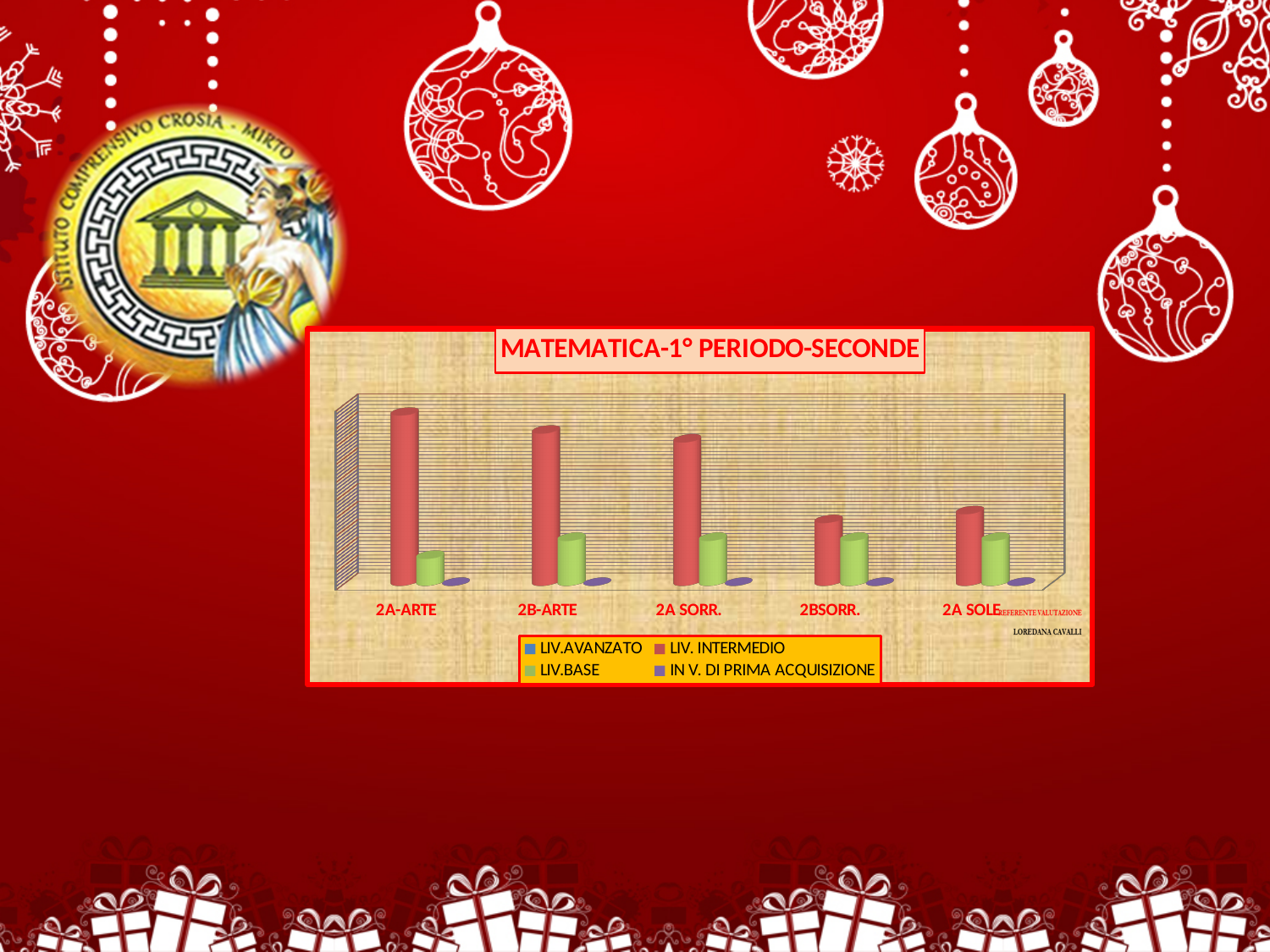
Which class has the lowest LIV. INTERMEDIO bar? 2BSORR. How many classes (categories) are shown on the x axis of the chart? 5 Which colour represents LIV.BASE in the legend? green How many series does the chart legend list? 4 Which class has the larger LIV. INTERMEDIO bar, 2B-ARTE or 2A SOLE? 2B-ARTE Which class has the highest LIV. INTERMEDIO bar? 2A-ARTE What is the title of the chart? MATEMATICA-1° PERIODO-SECONDE Does the LIV. INTERMEDIO series rise or fall from 2A-ARTE to 2BSORR.? fall What kind of chart is shown on the slide? bar chart For 2A-ARTE, which is larger: LIV. INTERMEDIO or LIV.BASE? LIV. INTERMEDIO Which class has the larger LIV. INTERMEDIO bar, 2A-ARTE or 2BSORR.? 2A-ARTE